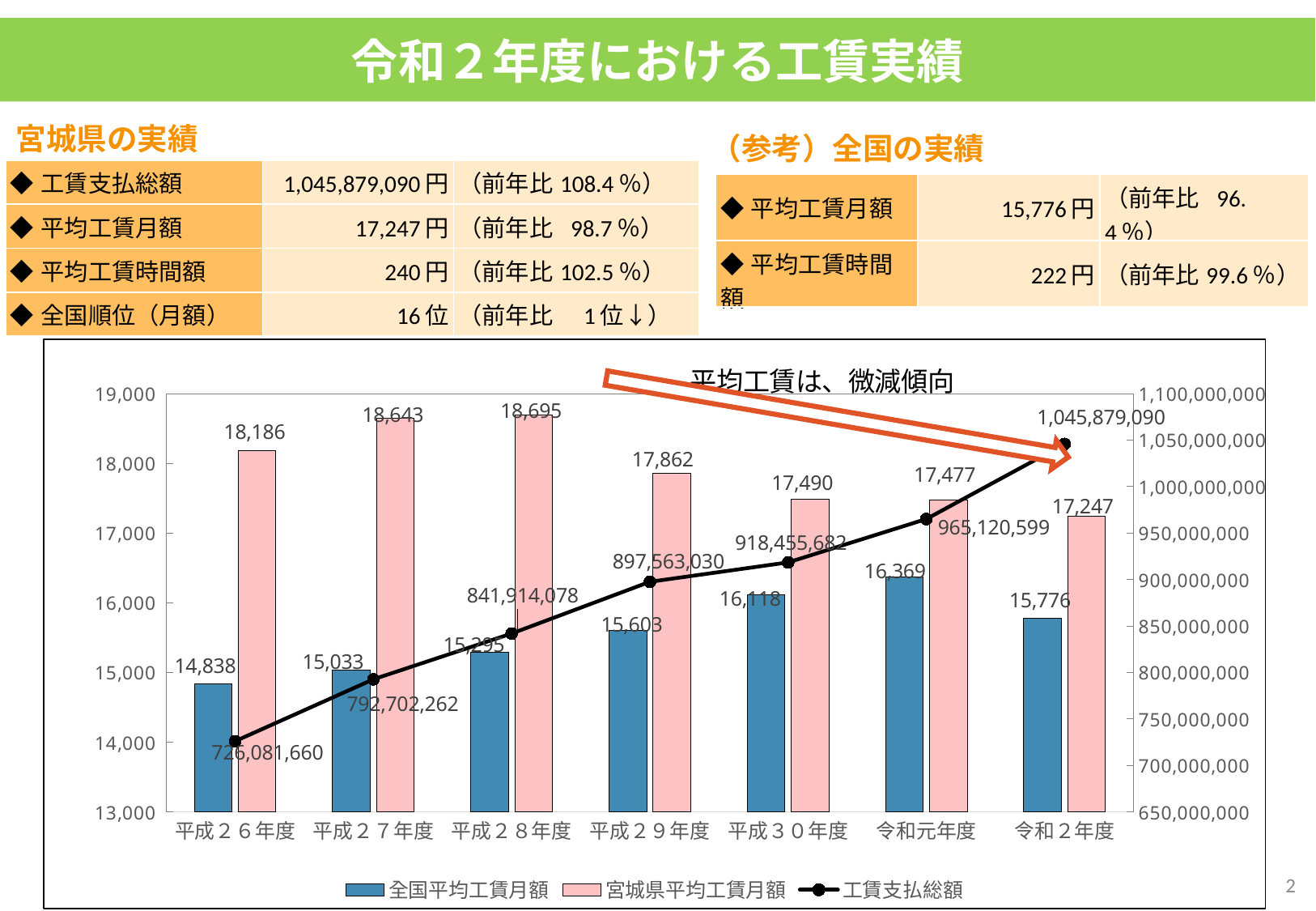
What is the value of 宮城県平均工賃月額 for 平成２６年度? 18,186 How many years are shown on the x axis of the chart? 7 What kind of chart is shown on the slide? Combined bar and line chart What is the difference between 宮城県平均工賃月額 and 全国平均工賃月額 in 令和２年度? 1,471 In which year is 宮城県平均工賃月額 highest? 平成２８年度 Which is larger in 平成３０年度: 宮城県平均工賃月額 or 全国平均工賃月額? 宮城県平均工賃月額 Does 工賃支払総額 rise or fall from 平成２６年度 to 令和２年度? Rise Which series is drawn as a black line with markers in the chart? 工賃支払総額 In which year is 全国平均工賃月額 lowest? 平成２６年度 How many series does the chart legend list? 3 What is the value of 全国平均工賃月額 for 令和元年度? 16,369 What is the value of 工賃支払総額 for 平成２９年度? 897,563,030